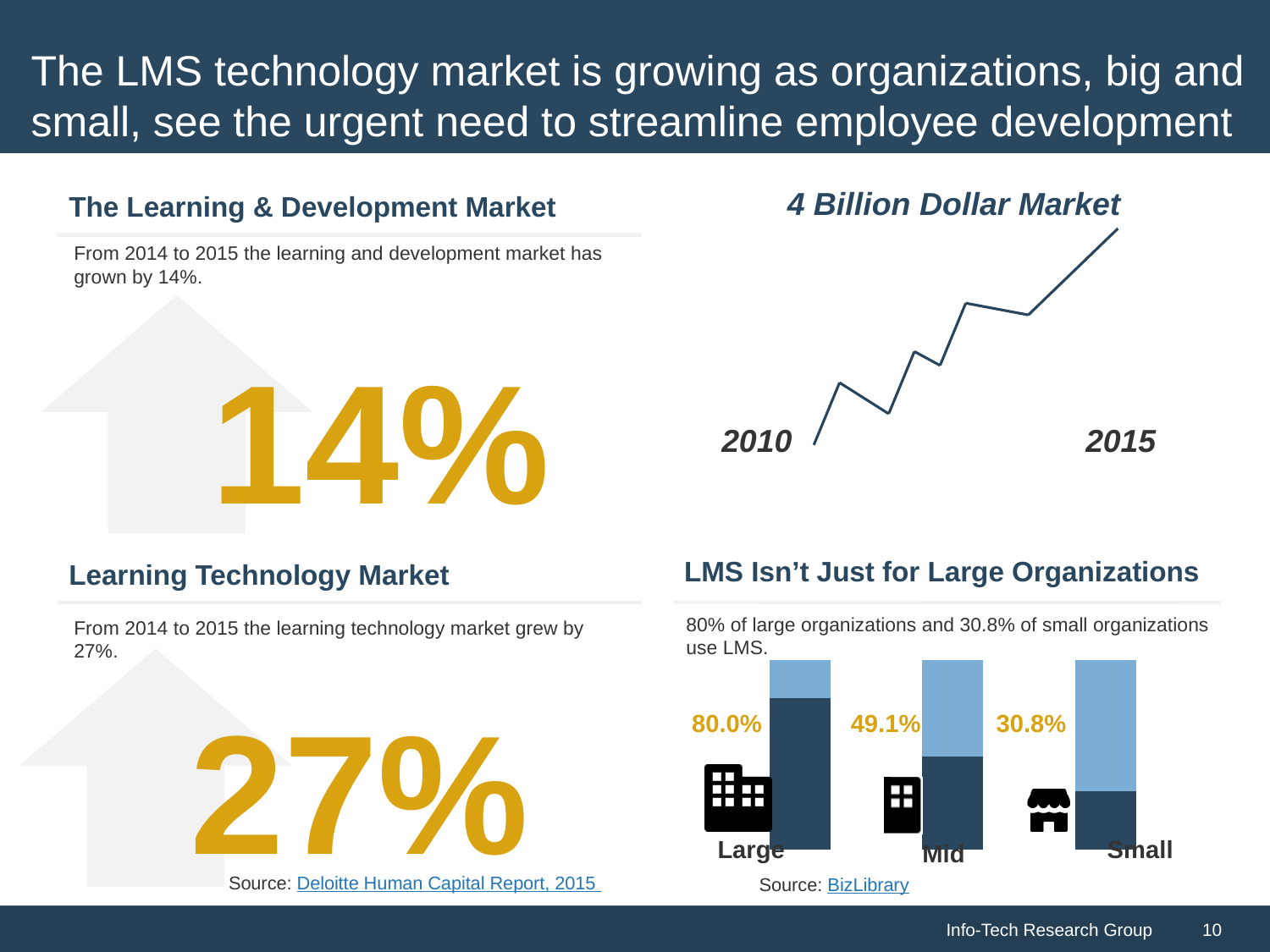
In the 'LMS Isn't Just for Large Organizations' chart, what is the difference between the Large and Mid percentages? 30.9% In the 'LMS Isn't Just for Large Organizations' chart, which organization size has the lowest percentage? Small What kind of chart is the '4 Billion Dollar Market' chart? Line chart In the 'LMS Isn't Just for Large Organizations' chart, which is larger, the percentage for Mid or for Small? Mid How many organization size categories are shown in the 'LMS Isn't Just for Large Organizations' chart? 3 In the '4 Billion Dollar Market' chart, does the line generally rise or fall from 2010 to 2015? Rise What kind of chart is the 'LMS Isn't Just for Large Organizations' chart? Bar chart In the 'LMS Isn't Just for Large Organizations' chart, what is the difference between the Large and Small percentages? 49.2% In the 'LMS Isn't Just for Large Organizations' chart, which organization size has the highest percentage? Large In the 'LMS Isn't Just for Large Organizations' chart, what percentage is shown for Large organizations? 80.0% In the 'LMS Isn't Just for Large Organizations' chart, what percentage is shown for Small organizations? 30.8% In the 'LMS Isn't Just for Large Organizations' chart, what percentage is shown for Mid organizations? 49.1%